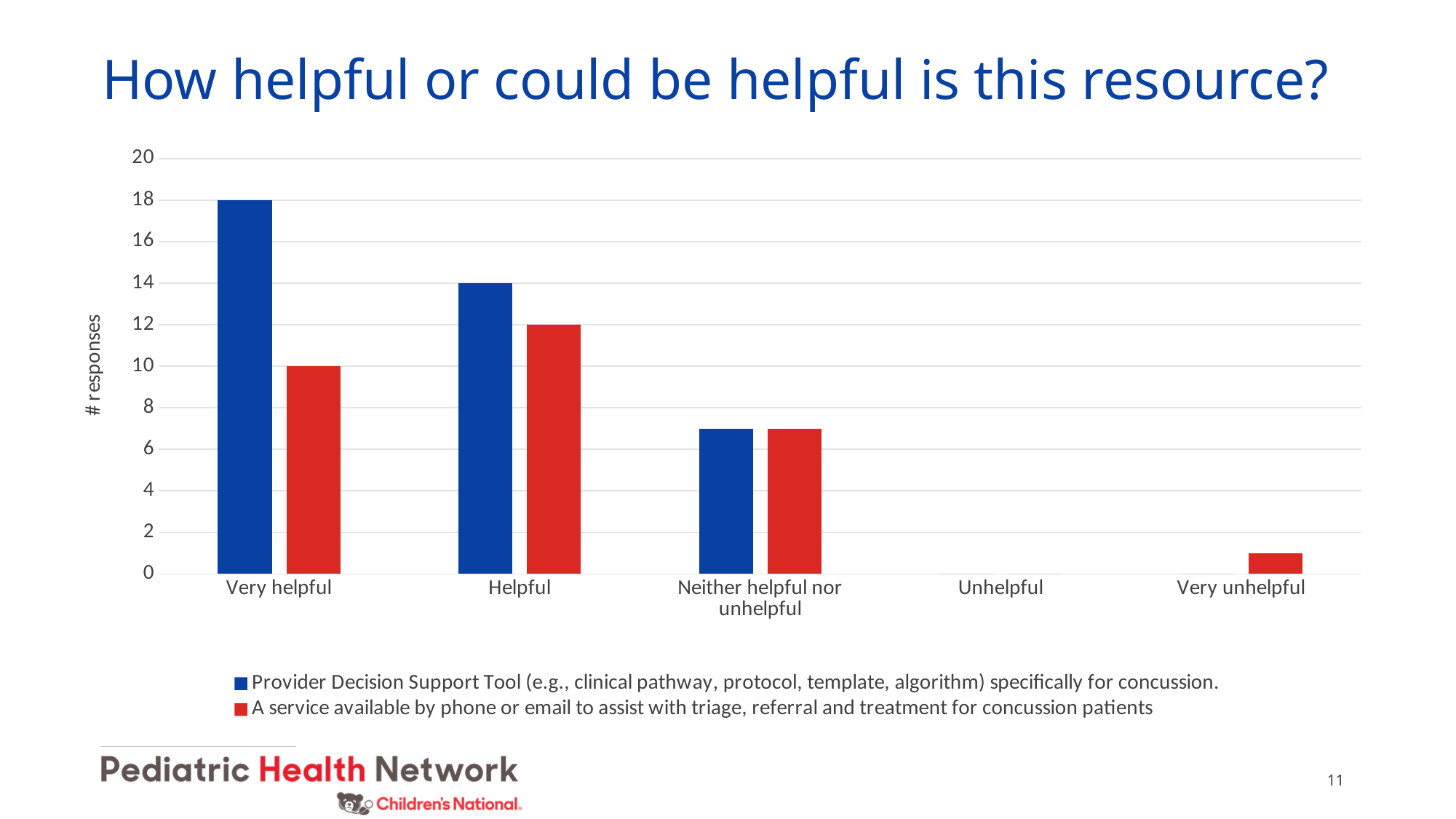
What kind of chart is shown on the slide? bar chart How many responses rated the phone or email service as Very helpful? 10 How many responses rated the phone or email service as Helpful? 12 How many series does the legend list? 2 Which series has more responses in the Helpful category? Provider Decision Support Tool What is the difference between the Provider Decision Support Tool and the phone or email service in the Very helpful category? 8 How many responses rated the Provider Decision Support Tool as Very helpful? 18 Is the value for the phone or email service in the Very unhelpful category greater or less than 2? less How many categories are shown on the x axis? 5 Which category has the highest number of responses for the Provider Decision Support Tool? Very helpful Is the value for the phone or email service in the Neither helpful nor unhelpful category greater or less than 6? greater How many responses rated the Provider Decision Support Tool as Helpful? 14